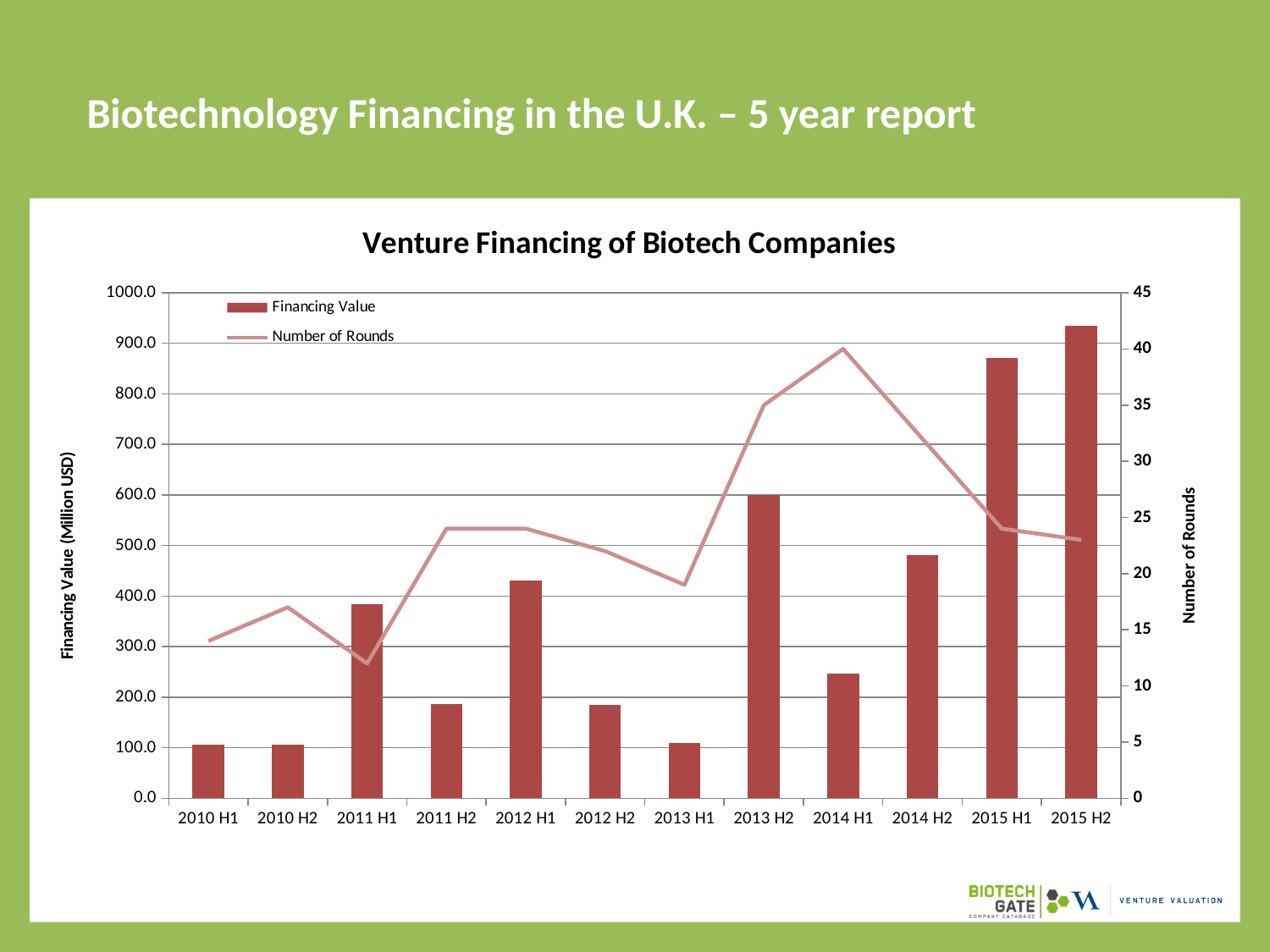
Does the Number of Rounds rise or fall from 2014 H1 to 2015 H2? fall How many half-year periods are shown on the x axis? 12 Is the Financing Value for 2013 H2 greater or less than 500.0? greater Which period has the highest Financing Value? 2015 H2 How many series does the legend list? 2 Is the Number of Rounds for 2014 H1 greater or less than 35? greater Which has the larger Financing Value, 2013 H2 or 2014 H2? 2013 H2 What is the label of the left vertical axis? Financing Value (Million USD) Which period has the highest Number of Rounds? 2014 H1 What type of chart is shown on the slide? A combined bar and line chart Is the Financing Value for 2014 H1 greater or less than 300.0? less Which period has the lowest Number of Rounds? 2011 H1